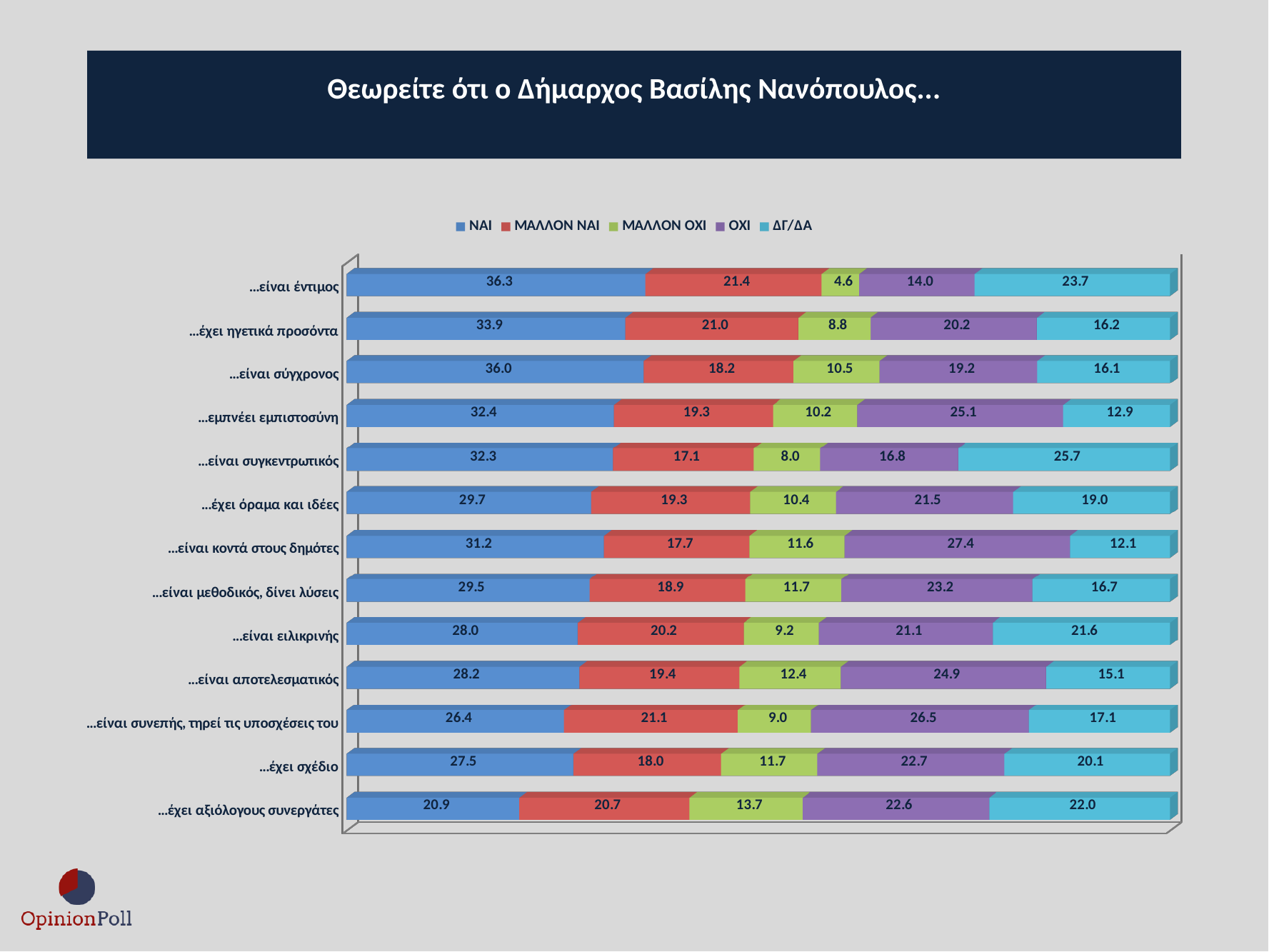
How many series does the legend list? 5 What is the ΔΓ/ΔΑ value for '...είναι συγκεντρωτικός'? 25.7 What type of chart is shown on the slide? Stacked horizontal bar chart What is the ΟΧΙ value for '...είναι κοντά στους δημότες'? 27.4 Which category has the highest ΟΧΙ value? ...είναι κοντά στους δημότες Which category has the lowest ΜΑΛΛΟΝ ΟΧΙ value? ...είναι έντιμος What is the difference between the ΝΑΙ value for '...είναι έντιμος' and the ΝΑΙ value for '...έχει αξιόλογους συνεργάτες'? 15.4 How many categories (statements) are plotted on the chart? 13 What is the total of the stacked bar for '...είναι έντιμος'? 100.0 Which is larger: the ΔΓ/ΔΑ value for '...είναι ειλικρινής' or the ΔΓ/ΔΑ value for '...είναι αποτελεσματικός'? ...είναι ειλικρινής What is the ΝΑΙ value for '...είναι έντιμος'? 36.3 Which category has the lowest ΝΑΙ value? ...έχει αξιόλογους συνεργάτες